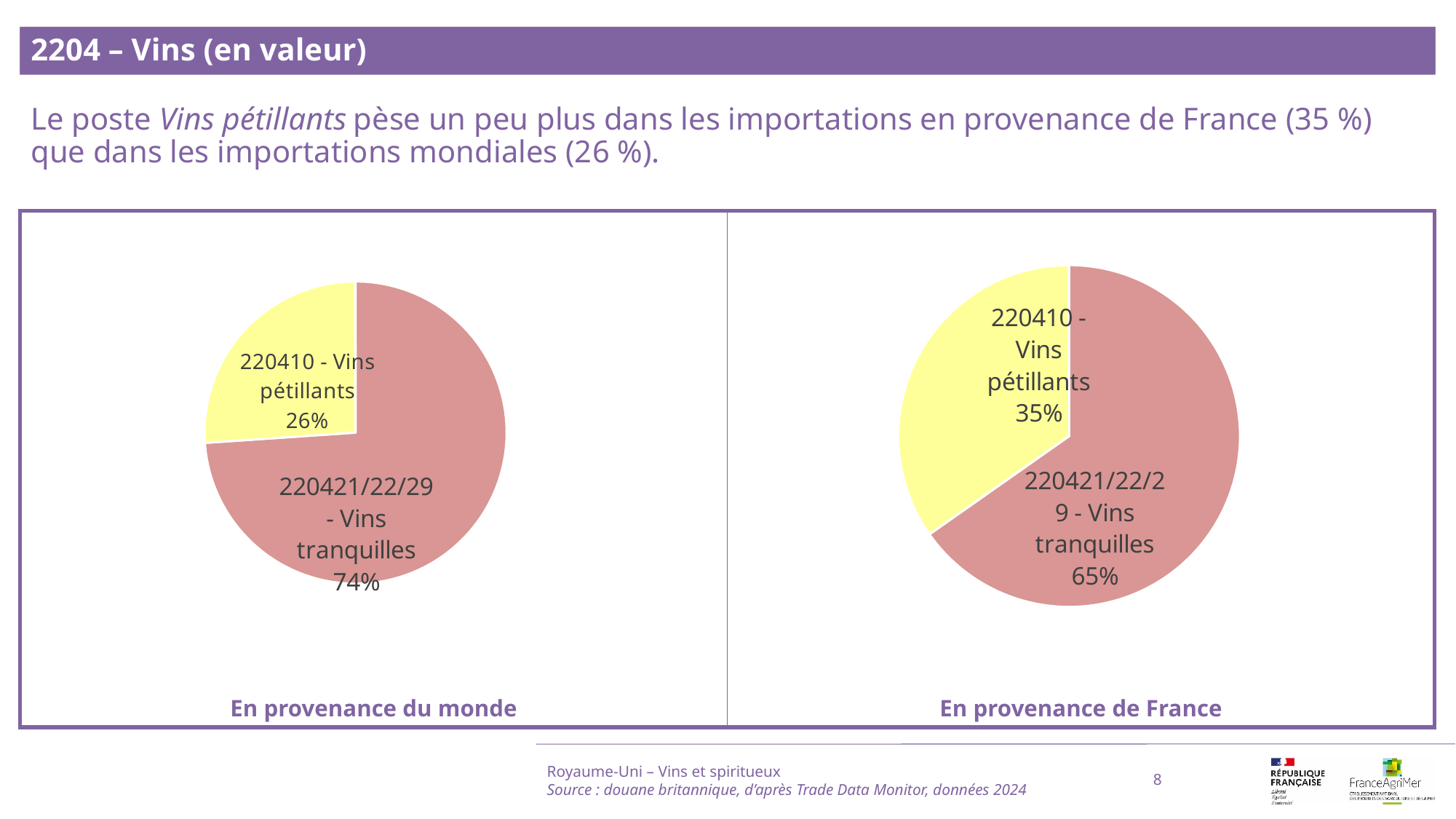
In the 'En provenance de France' pie chart, what share does '220410 - Vins pétillants' have? 35% In the 'En provenance de France' pie chart, what colour is the Vins pétillants slice? Yellow In the 'En provenance de France' pie chart, which slice is the smallest? 220410 - Vins pétillants In the 'En provenance du monde' pie chart, what share does '220421/22/29 - Vins tranquilles' have? 74% Which chart shows a larger share for Vins pétillants, 'En provenance du monde' or 'En provenance de France'? En provenance de France In the 'En provenance de France' pie chart, what is the difference between the shares of Vins tranquilles and Vins pétillants? 30% In the 'En provenance du monde' pie chart, which slice is the largest? 220421/22/29 - Vins tranquilles How many slices does the 'En provenance du monde' pie chart have? 2 In the 'En provenance de France' pie chart, what share does '220421/22/29 - Vins tranquilles' have? 65% What type of chart is used on the left side of the slide ('En provenance du monde')? Pie chart In the 'En provenance du monde' pie chart, what is the difference between the shares of Vins tranquilles and Vins pétillants? 48%